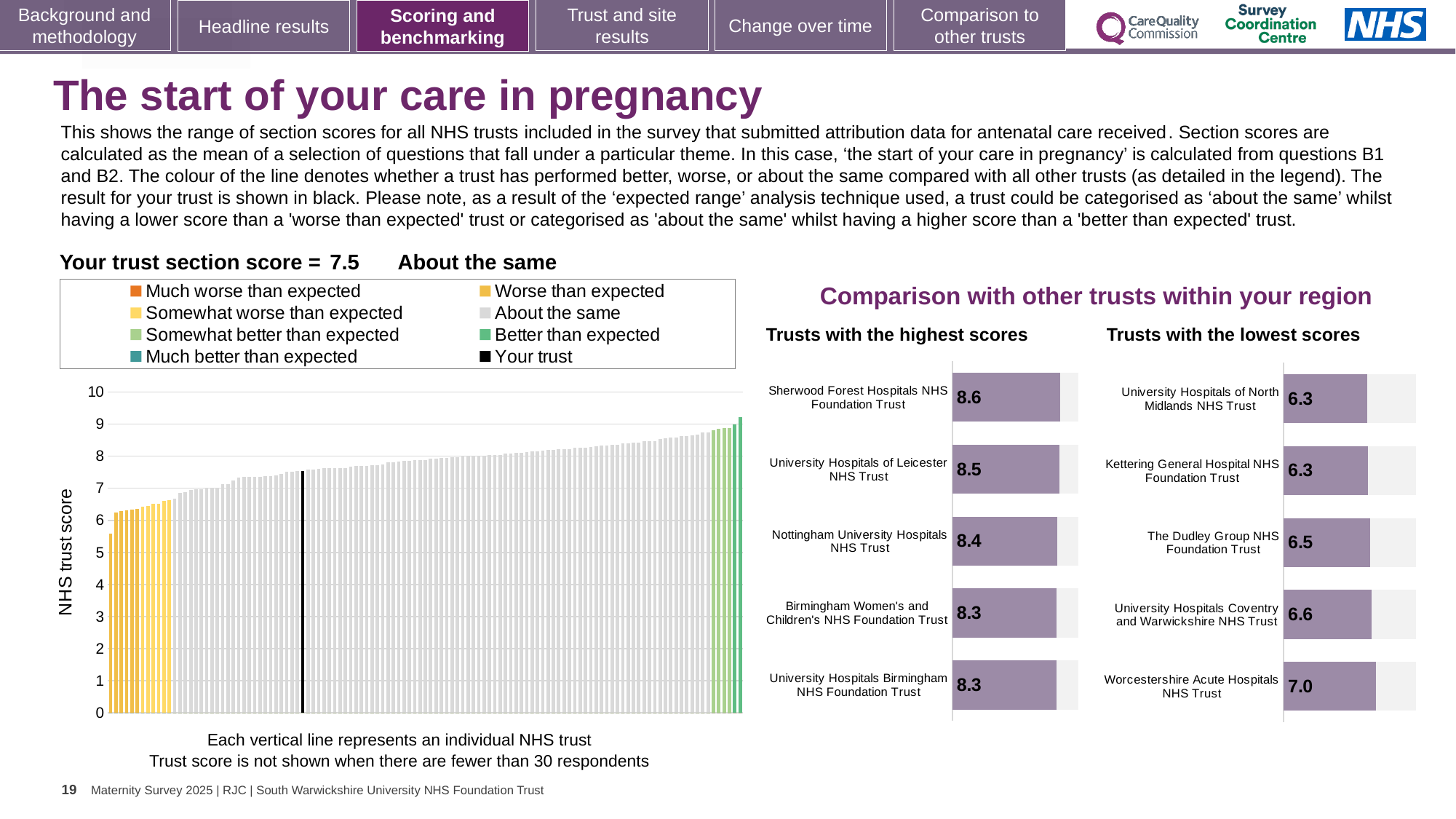
What kind of chart is the NHS trust score chart on the left of the slide? Bar chart In the 'Trusts with the highest scores' chart, which trust has the highest score? Sherwood Forest Hospitals NHS Foundation Trust In the 'Trusts with the highest scores' chart, what is the score for Sherwood Forest Hospitals NHS Foundation Trust? 8.6 In the NHS trust score chart, do the bar values rise or fall from left to right? Rise How many entries does the legend of the NHS trust score chart list? 8 Which has the larger score: Nottingham University Hospitals NHS Trust in the highest scores chart or The Dudley Group NHS Foundation Trust in the lowest scores chart? Nottingham University Hospitals NHS Trust What is the section score for your trust shown on the slide? 7.5 In the 'Trusts with the lowest scores' chart, what is the score for Worcestershire Acute Hospitals NHS Trust? 7.0 How many trusts are listed in the 'Trusts with the highest scores' chart? 5 In the 'Trusts with the lowest scores' chart, what is the difference between The Dudley Group NHS Foundation Trust and Kettering General Hospital NHS Foundation Trust? 0.2 In the 'Trusts with the lowest scores' chart, which trust has the highest score? Worcestershire Acute Hospitals NHS Trust What is the difference between the score for Sherwood Forest Hospitals NHS Foundation Trust in the highest scores chart and Worcestershire Acute Hospitals NHS Trust in the lowest scores chart? 1.6